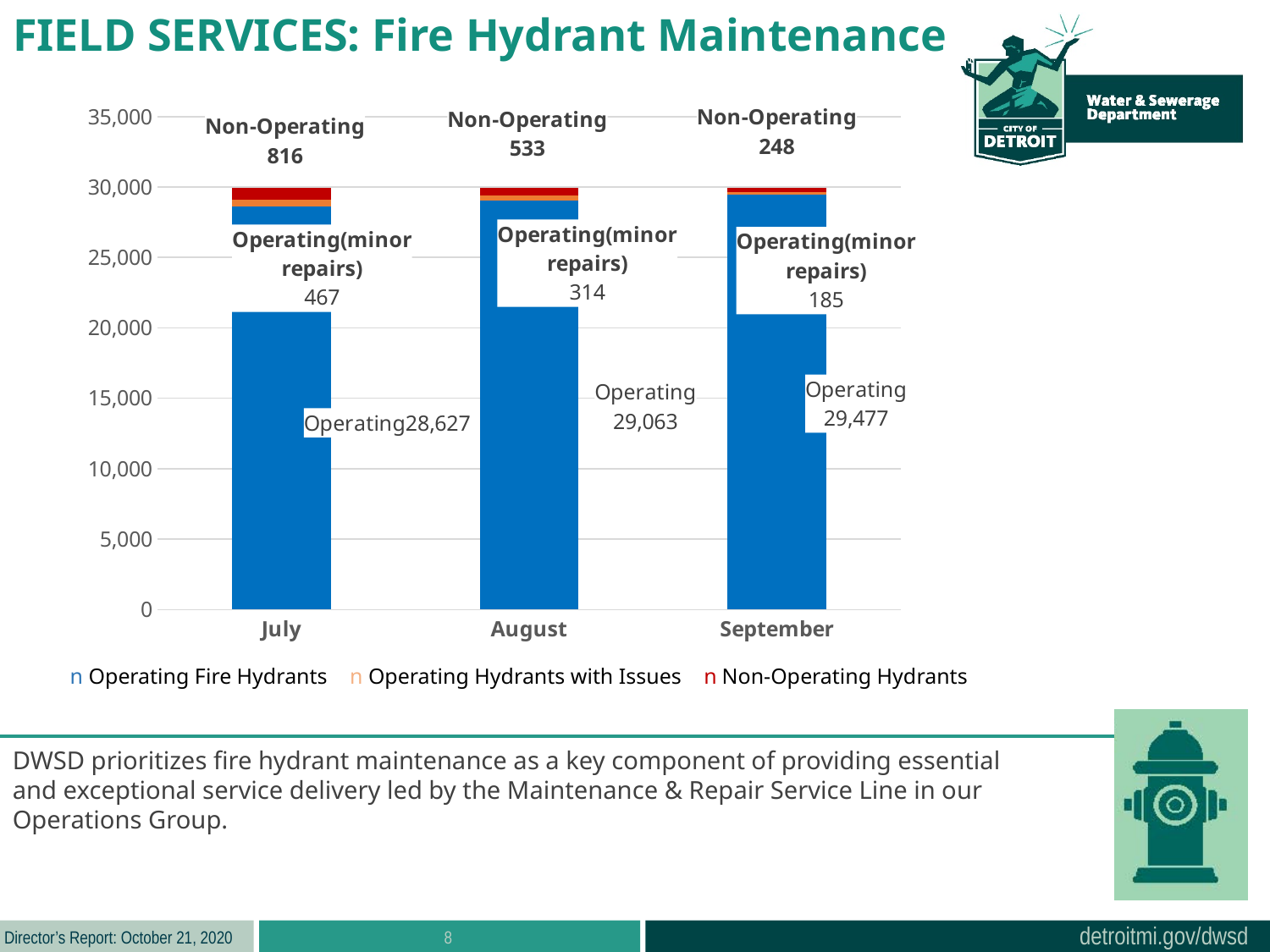
How many series does the chart legend list? 3 What kind of chart is shown on the slide? Stacked bar chart Which month has the highest number of Non-Operating hydrants? July Do the Operating fire hydrant values rise or fall from July to September? Rise Which is larger, the number of Operating hydrants in August or in September? September What is the number of Operating fire hydrants in July? 28,627 What is the number of Operating (minor repairs) hydrants in August? 314 What is the total of the stacked bar for September? 29,910 What is the number of Non-Operating hydrants in September? 248 What is the difference between the Non-Operating hydrants in July and in August? 283 Which month has the lowest number of Operating (minor repairs) hydrants? September How many months are shown on the x axis of the chart? 3